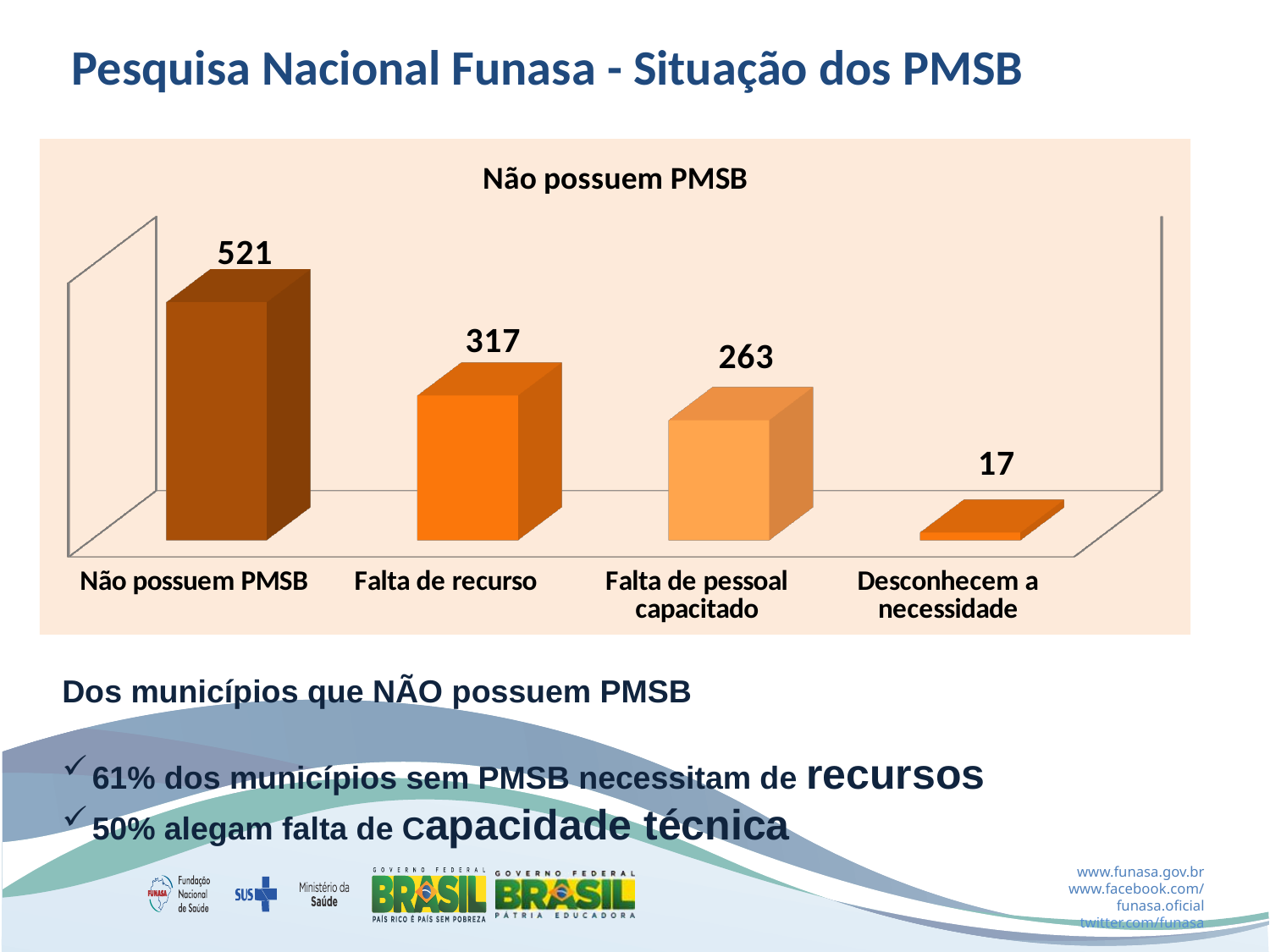
How many categories are shown in the chart? 4 What is the value for "Falta de recurso"? 317 What is the value for "Desconhecem a necessidade"? 17 Which category has the highest value? Não possuem PMSB What is the title of the chart? Não possuem PMSB Which is larger, the value for "Falta de pessoal capacitado" or the value for "Desconhecem a necessidade"? Falta de pessoal capacitado What is the difference between the values for "Não possuem PMSB" and "Falta de recurso"? 204 Do the values rise or fall from left to right across the categories? Fall What is the value for "Falta de pessoal capacitado"? 263 What kind of chart is shown on the slide? Bar chart Which category has the lowest value? Desconhecem a necessidade What is the difference between the values for "Falta de recurso" and "Falta de pessoal capacitado"? 54